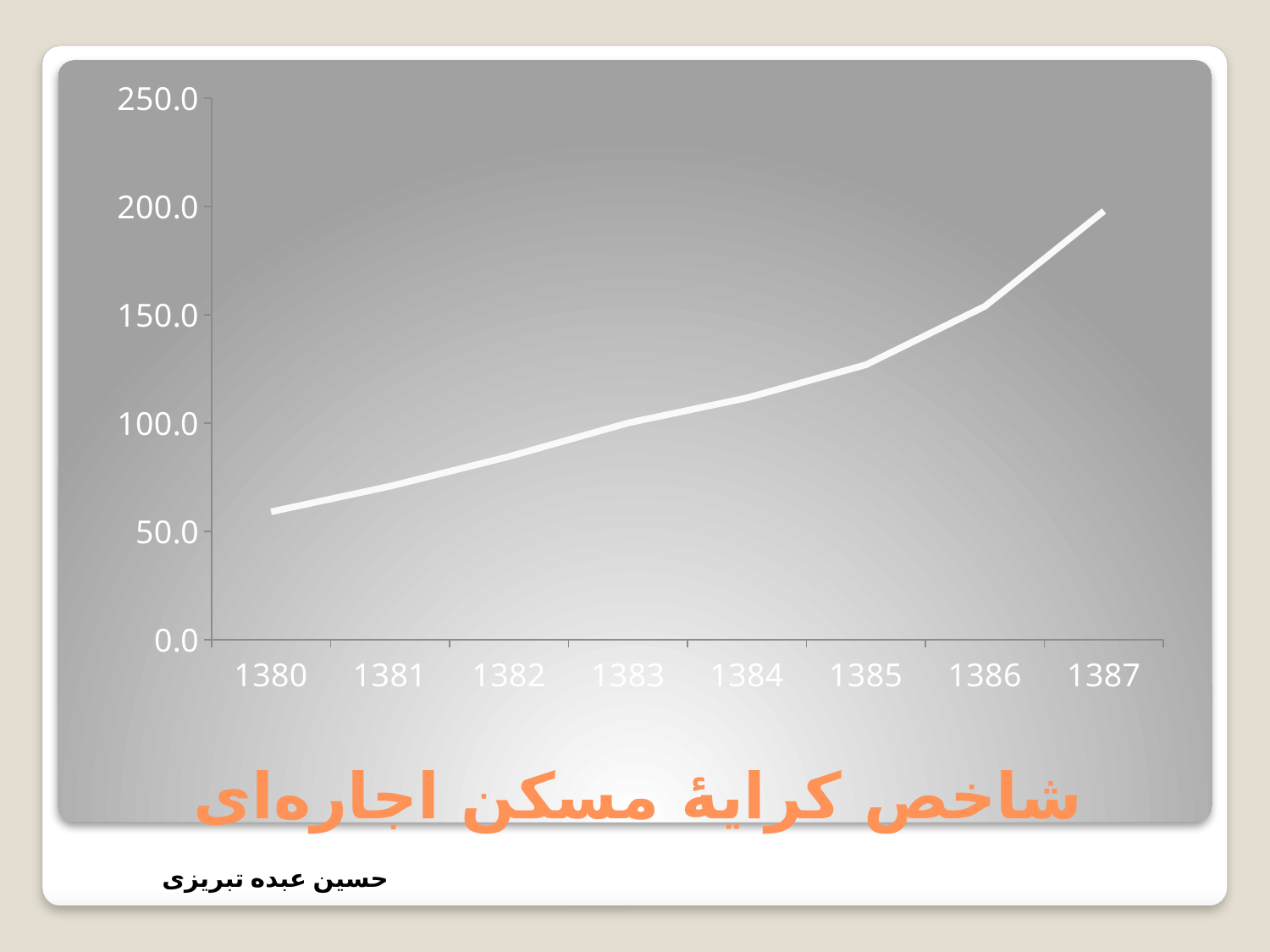
Which year has the highest value in the chart? 1387 Is the value for 1380 greater or less than 100? less Do the values in the chart rise or fall from 1380 to 1387? rise What is the first year shown on the x axis of the chart? 1380 Is the value for 1385 greater or less than 100? greater Which year has the lowest value in the chart? 1380 What kind of chart is shown on the slide? line chart Is the value for 1382 greater or less than 100? less How many years are plotted along the x axis of the chart? 8 Which year has the larger value, 1381 or 1386? 1386 What is the highest value shown on the y axis of the chart? 250.0